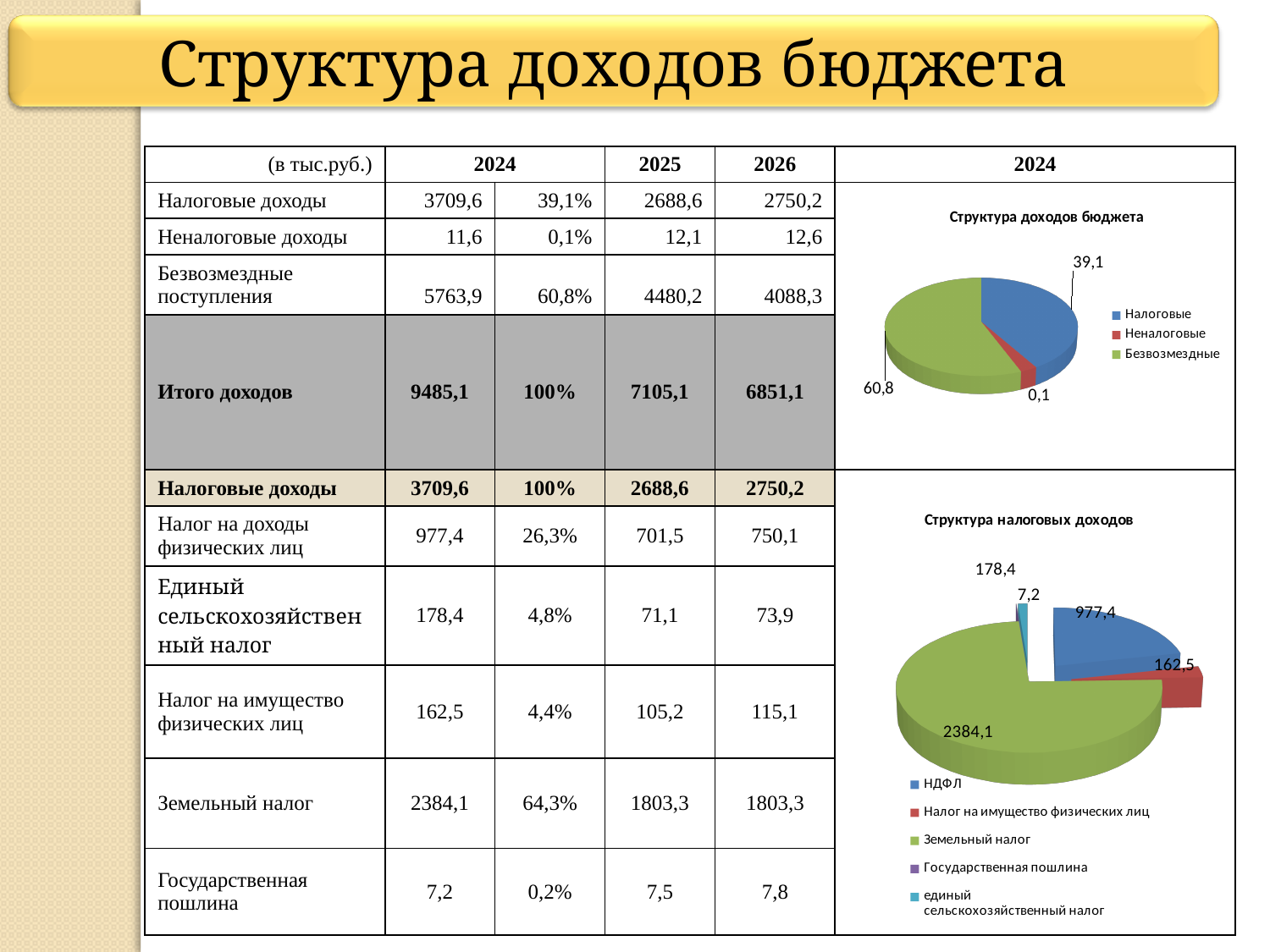
What kind of chart is the chart titled "Структура доходов бюджета"? pie chart In the chart titled "Структура налоговых доходов", what value is shown for НДФЛ? 977,4 In the chart titled "Структура доходов бюджета", what value is shown for Неналоговые? 0,1 In the chart titled "Структура доходов бюджета", which category has the largest slice? Безвозмездные In the chart titled "Структура налоговых доходов", what colour is the slice for Земельный налог? green How many categories does the legend of the chart titled "Структура налоговых доходов" list? 5 In the chart titled "Структура доходов бюджета", what value is shown for Налоговые? 39,1 In the chart titled "Структура налоговых доходов", what value is shown for Земельный налог? 2384,1 How many categories does the legend of the chart titled "Структура доходов бюджета" list? 3 In the chart titled "Структура налоговых доходов", which category has the smallest slice? Государственная пошлина In the chart titled "Структура налоговых доходов", what is the difference between Земельный налог and НДФЛ? 1406,7